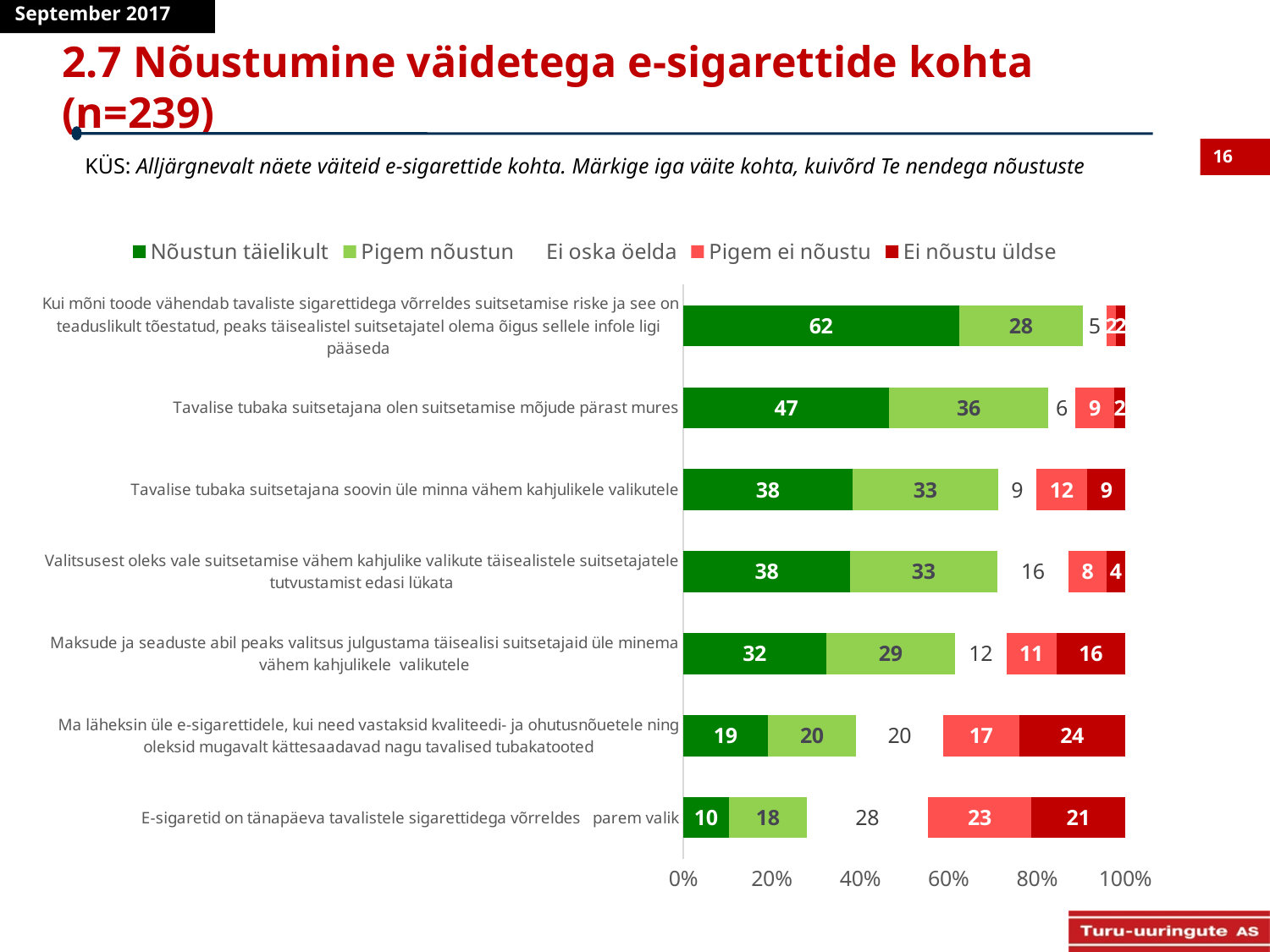
What is the difference between the 'Pigem nõustun' values for 'Tavalise tubaka suitsetajana olen suitsetamise mõjude pärast mures' and 'Maksude ja seaduste abil peaks valitsus julgustama täisealisi suitsetajaid üle minema vähem kahjulikele valikutele'? 7 How many statements (categories) are plotted in the chart? 7 How many series does the legend list? 5 What is the 'Ei nõustu üldse' value for the statement 'Ma läheksin üle e-sigarettidele, kui need vastaksid kvaliteedi- ja ohutusnõuetele ning oleksid mugavalt kättesaadavad nagu tavalised tubakatooted'? 24 What is the combined 'Nõustun täielikult' and 'Pigem nõustun' value for the statement 'Tavalise tubaka suitsetajana soovin üle minna vähem kahjulikele valikutele'? 71 Which is larger for the statement 'E-sigaretid on tänapäeva tavalistele sigarettidega võrreldes parem valik': the 'Pigem ei nõustu' value or the 'Ei nõustu üldse' value? Pigem ei nõustu Which statement has the highest 'Nõustun täielikult' value? Kui mõni toode vähendab tavaliste sigarettidega võrreldes suitsetamise riske ja see on teaduslikult tõestatud, peaks täisealistel suitsetajatel olema õigus sellele infole ligi pääseda What type of chart is shown on the slide? Stacked bar chart Which statement has the lowest 'Nõustun täielikult' value? E-sigaretid on tänapäeva tavalistele sigarettidega võrreldes parem valik What is the 'Ei oska öelda' value for the statement 'E-sigaretid on tänapäeva tavalistele sigarettidega võrreldes parem valik'? 28 Which legend entry is shown in dark red? Ei nõustu üldse What is the 'Nõustun täielikult' value for the statement 'Tavalise tubaka suitsetajana olen suitsetamise mõjude pärast mures'? 47